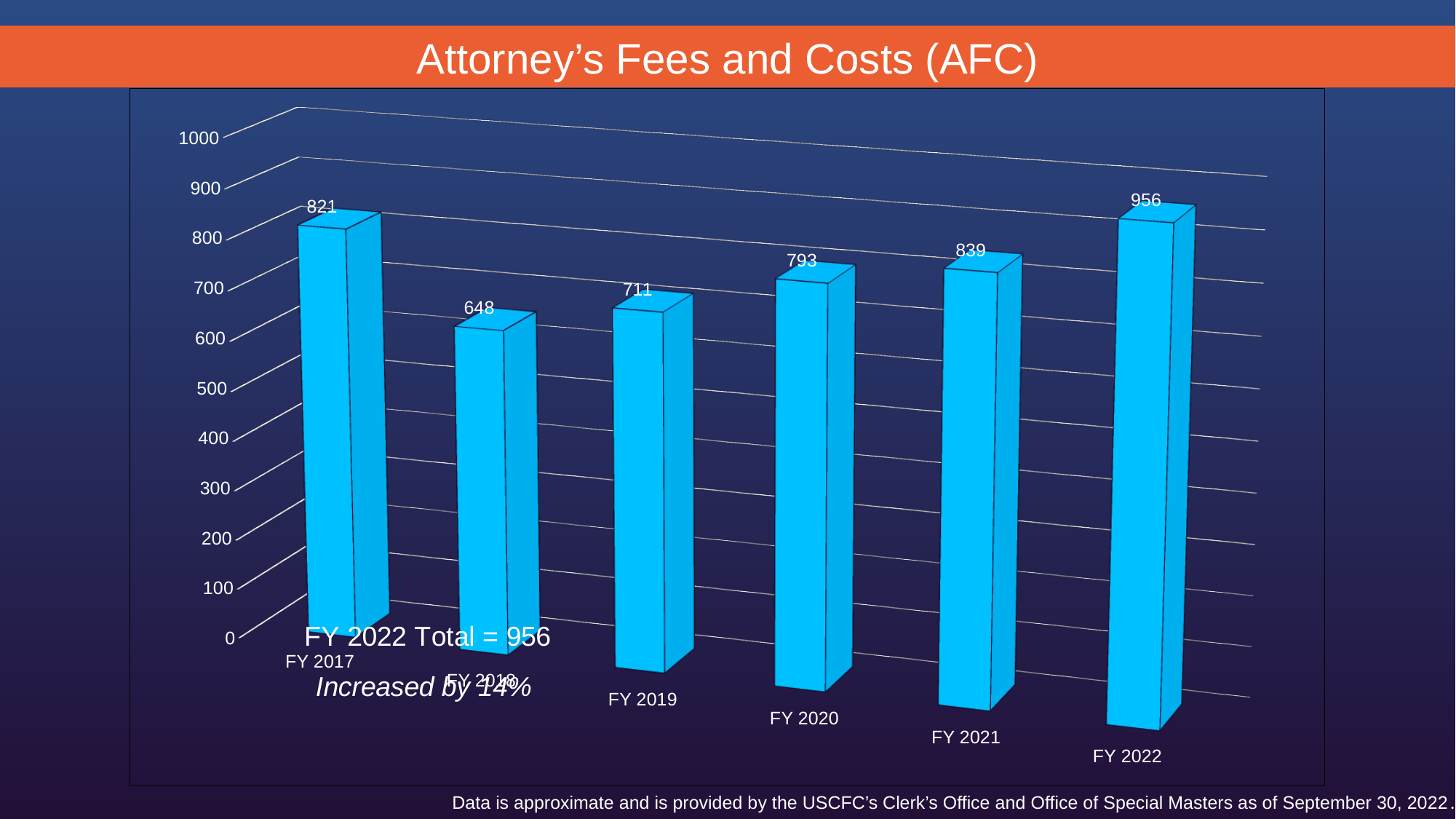
What is the value for FY 2022? 956 What is the value for FY 2020? 793 Which is larger, the value for FY 2019 or the value for FY 2020? FY 2020 What is the value for FY 2018? 648 What is the title of the chart? Attorney's Fees and Costs (AFC) Which fiscal year has the lowest value? FY 2018 What is the value for FY 2017? 821 What is the difference between the values for FY 2017 and FY 2018? 173 Which fiscal year has the highest value? FY 2022 How many fiscal years are shown in the chart? 6 What is the difference between the values for FY 2022 and FY 2021? 117 What kind of chart is shown on the slide? Bar chart